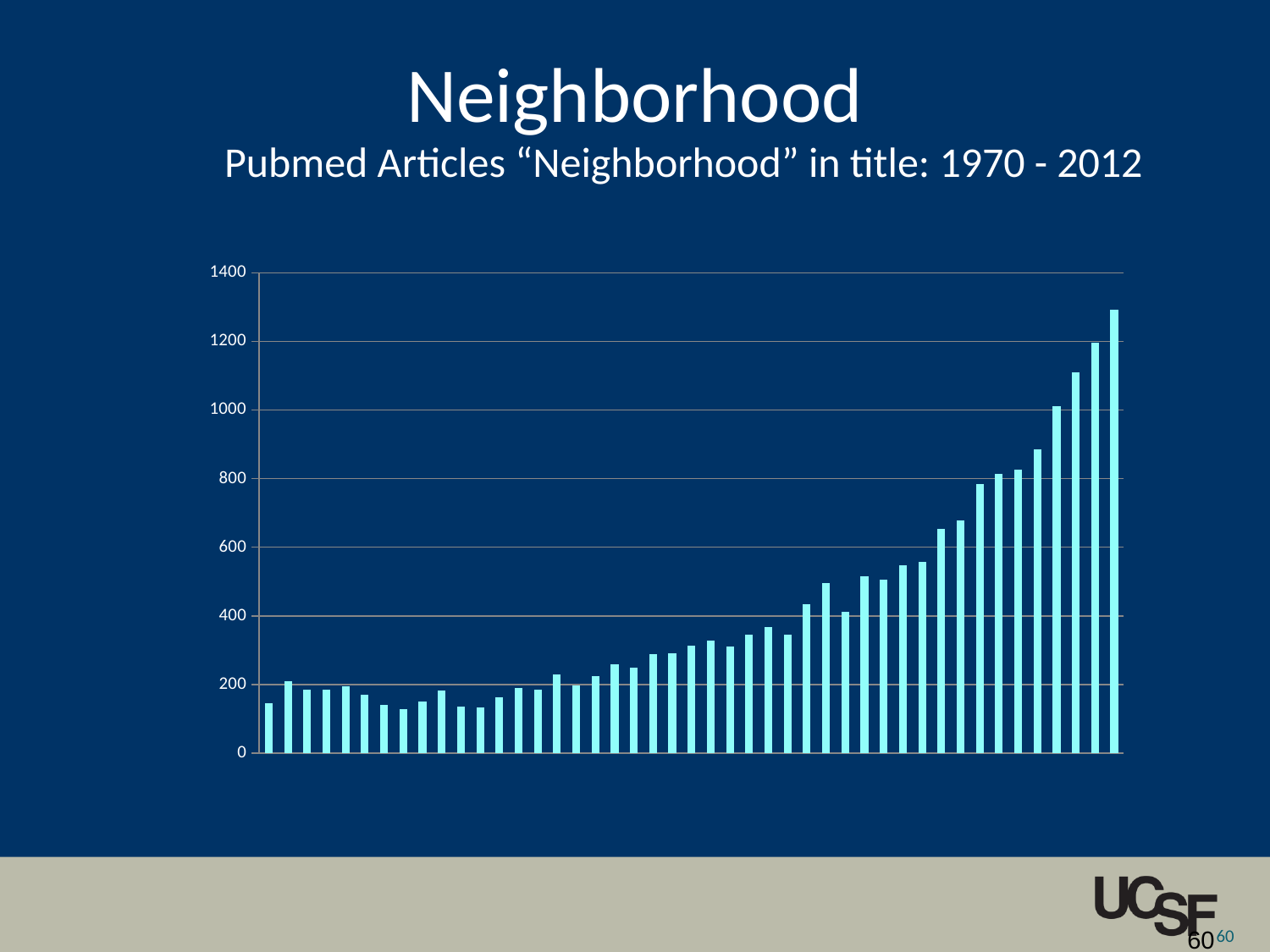
Is the rightmost bar taller or shorter than the leftmost bar? taller Is the value of the rightmost (last) bar greater or less than 1200? greater What is the title of the chart on the slide? Pubmed Articles "Neighborhood" in title: 1970 - 2012 What kind of chart is shown on the slide? bar chart What is the highest value shown on the vertical axis? 1400 Is the value of the second-to-last bar greater or less than 1000? greater Is the value of the bar in the middle of the chart greater or less than 600? less Overall, do the bar values rise or fall from left to right across the chart? rise Which bar is the tallest in the chart, the leftmost or the rightmost? rightmost